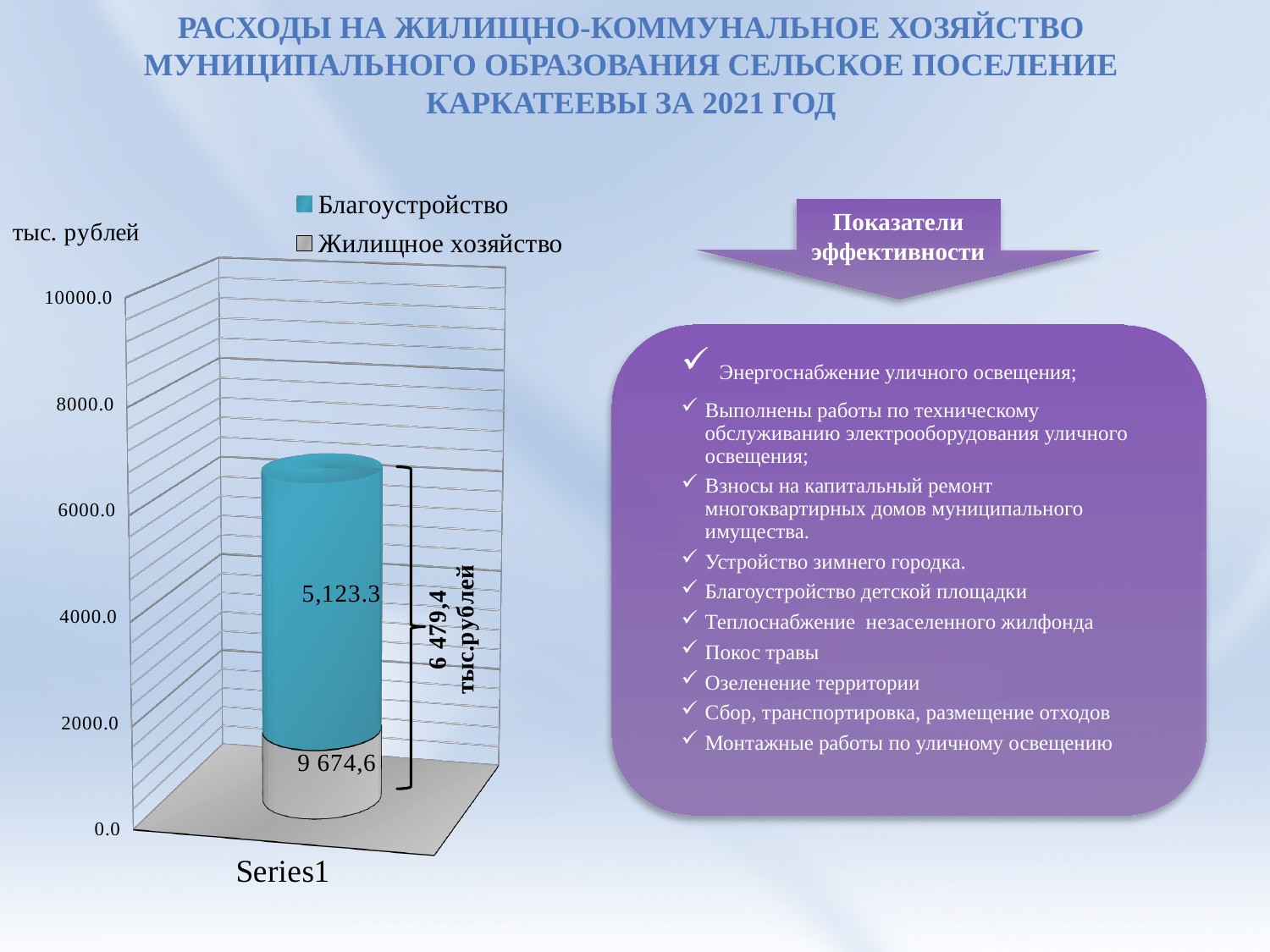
What is the category label shown under the bar? Series1 What is the highest tick value shown on the vertical axis? 10000.0 What total is shown by the bracket next to the stacked bar? 6 479,4 тыс.рублей Which segment of the bar is larger, Благоустройство or Жилищное хозяйство? Благоустройство How many categories are plotted on the x axis of the chart? 1 What value is printed on the Жилищное хозяйство segment of the bar? 9 674,6 What unit is shown for the vertical axis of the chart? тыс. рублей Is the top of the stacked bar greater or less than 6000.0 on the axis? greater How many series does the legend list? 2 What is the value printed for the Благоустройство segment of the bar? 5,123.3 What kind of chart is shown on the slide? Stacked bar chart